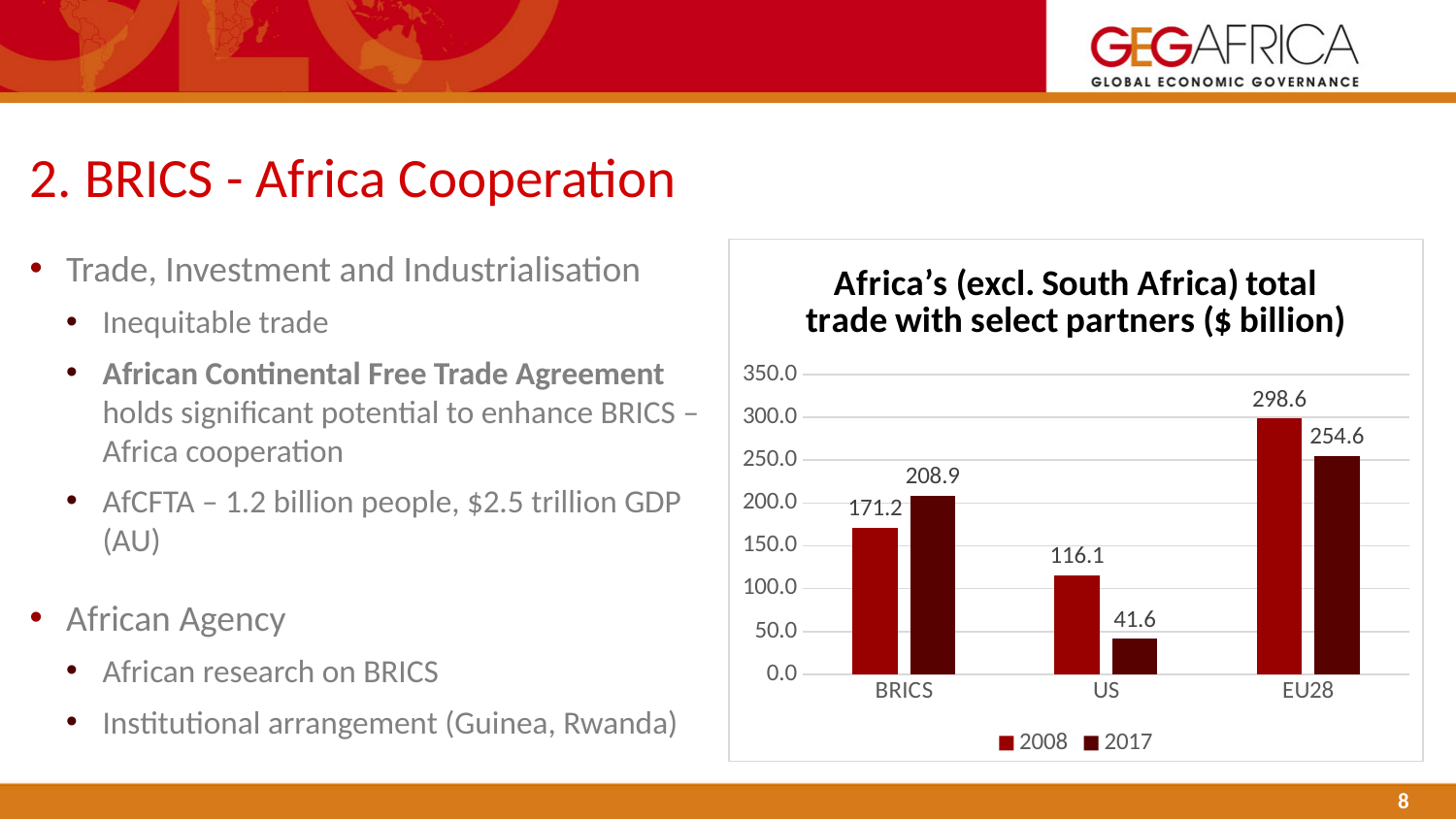
What was Africa's (excl. South Africa) total trade with BRICS in 2017? 208.9 What is the difference between the 2008 and 2017 trade values for the US? 74.5 Which was larger in 2017: Africa's trade with BRICS or with EU28? EU28 What was Africa's (excl. South Africa) total trade with the US in 2008? 116.1 How many series does the chart legend list? 2 Which partner had the lowest trade value with Africa (excl. South Africa) in 2017? US What type of chart is shown on the slide? Bar chart How many partner categories are shown on the x axis of the chart? 3 Which partner had the highest trade value with Africa (excl. South Africa) in 2008? EU28 By how much did Africa's (excl. South Africa) trade with BRICS increase from 2008 to 2017? 37.7 What is the title of the chart on the slide? Africa's (excl. South Africa) total trade with select partners ($ billion) What was Africa's (excl. South Africa) total trade with EU28 in 2017? 254.6